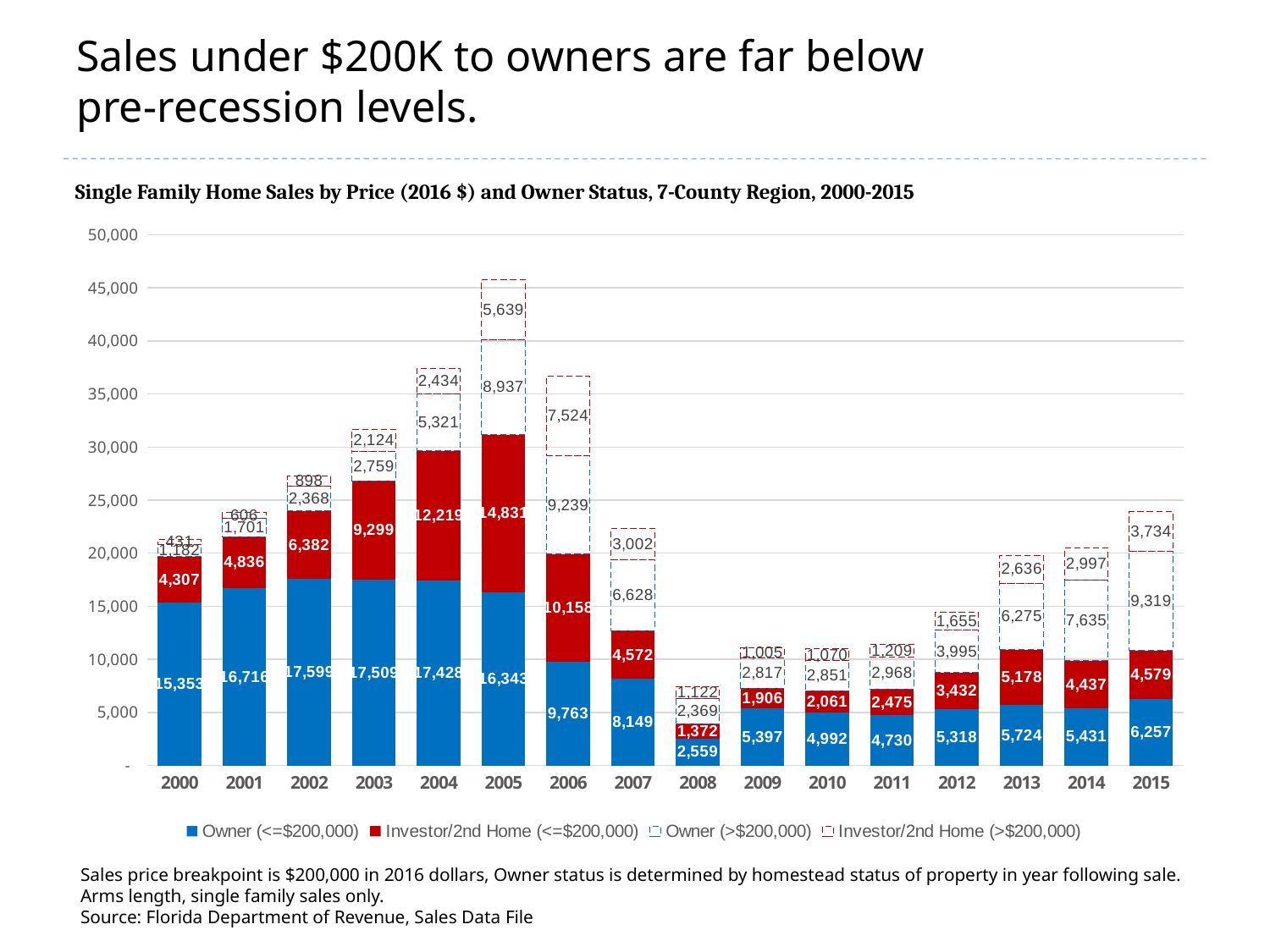
What is the difference between the Owner (<=$200,000) values in 2002 and 2015? 11,342 Which year has the highest value for Investor/2nd Home (<=$200,000)? 2005 What is the value for Investor/2nd Home (>$200,000) in 2006? 7,524 What is the value for Investor/2nd Home (<=$200,000) in 2005? 14,831 What type of chart is shown on the slide? Stacked bar chart What is the value for Owner (>$200,000) in 2015? 9,319 How many years are shown on the x axis? 16 What is the value for Owner (<=$200,000) in 2002? 17,599 Which year has the lowest value for Owner (<=$200,000)? 2008 Is the total of the stacked bar for 2005 greater or less than 40,000? greater What is the total of the stacked bar for 2015? 23,889 How many series does the legend list? 4